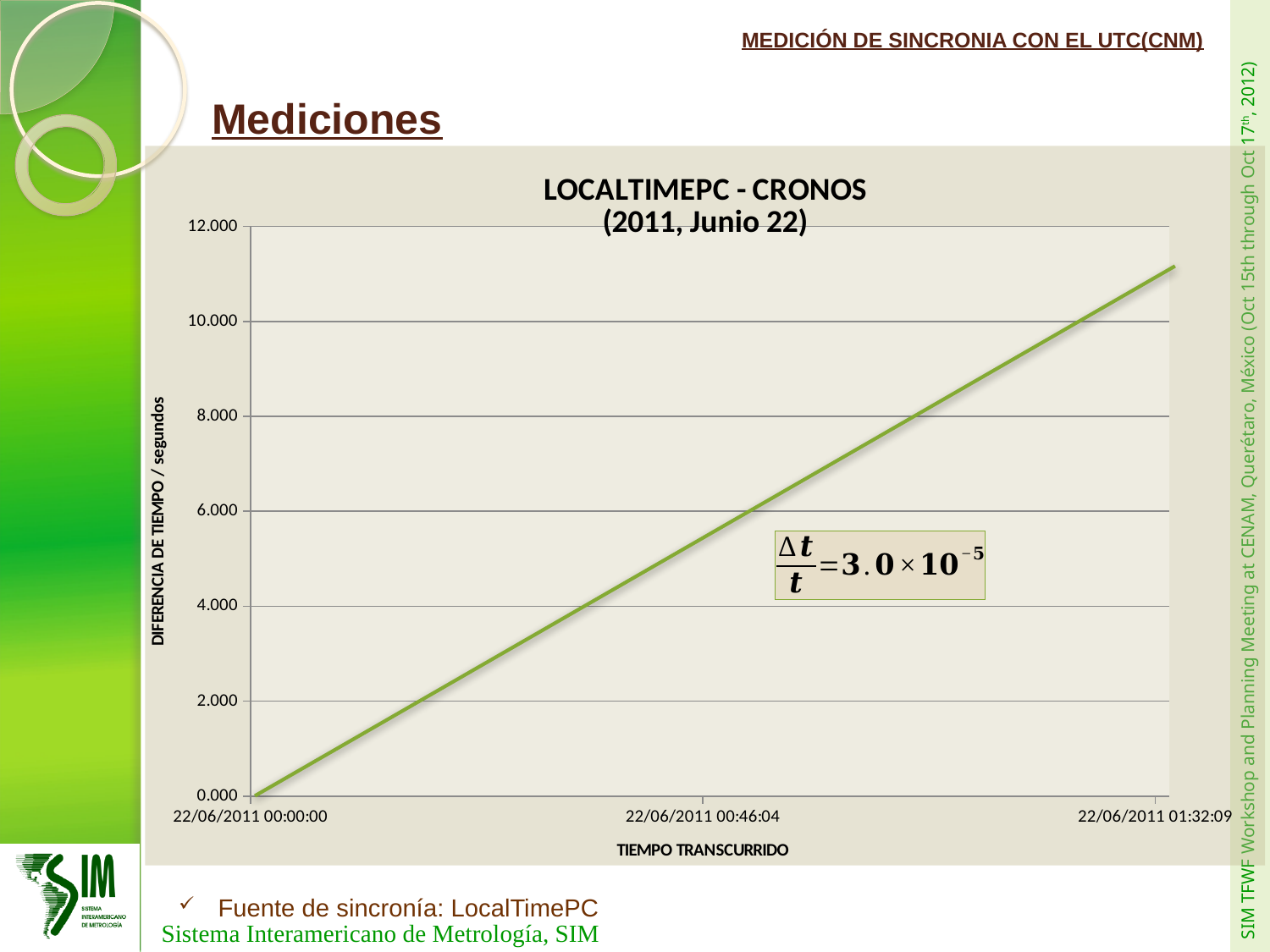
What is the title of the chart? LOCALTIMEPC - CRONOS (2011, Junio 22) Is the time difference at 22/06/2011 00:46:04 greater or less than 8.000 seconds? less At which x-axis time is the time difference highest? 22/06/2011 01:32:09 Is the time difference at 22/06/2011 00:46:04 greater or less than 4.000 seconds? greater Which has the larger time difference, 22/06/2011 00:46:04 or 22/06/2011 01:32:09? 22/06/2011 01:32:09 What kind of chart is shown on the slide? line chart How many time labels are shown on the x axis? 3 At which x-axis time is the time difference lowest? 22/06/2011 00:00:00 Does the time difference rise or fall as elapsed time increases along the x axis? rise What is the label of the y axis? DIFERENCIA DE TIEMPO / segundos Is the time difference at 22/06/2011 01:32:09 greater or less than 10.000 seconds? greater